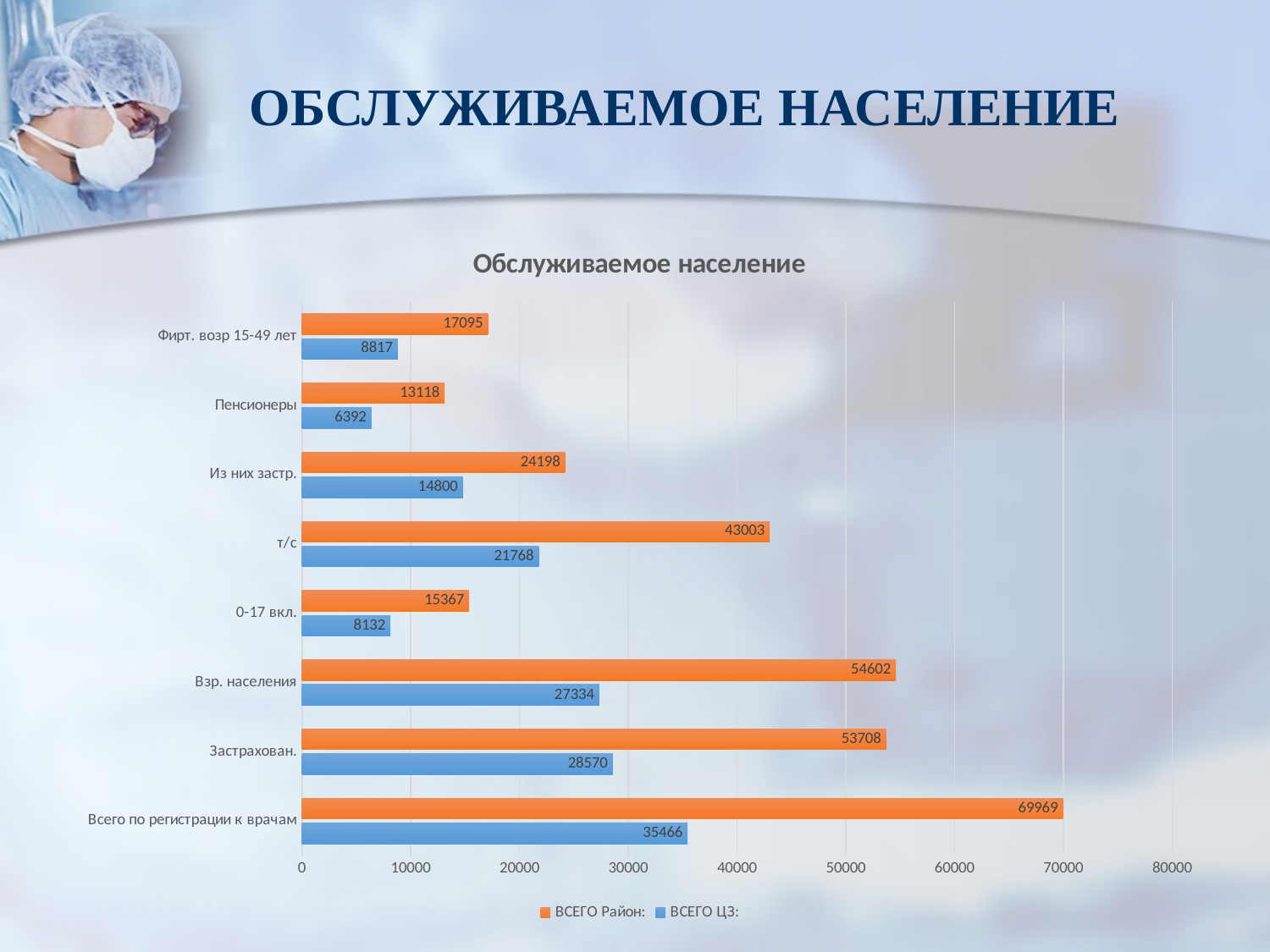
Which is larger: ВСЕГО ЦЗ: for Застрахован. or ВСЕГО ЦЗ: for Взр. населения? Застрахован. Which category has the lowest value for ВСЕГО Район:? Пенсионеры What is the value of ВСЕГО ЦЗ: for т/с? 21768 What is the value of ВСЕГО Район: for Из них застр.? 24198 Is the value of ВСЕГО Район: for т/с greater or less than 40000? greater What type of chart is shown on the slide? bar chart Which category has the highest value for ВСЕГО ЦЗ:? Всего по регистрации к врачам What is the difference between ВСЕГО Район: and ВСЕГО ЦЗ: for Взр. населения? 27268 How many series does the legend list? 2 What is the value of ВСЕГО Район: for Всего по регистрации к врачам? 69969 How many categories are shown on the chart? 8 What is the value of ВСЕГО ЦЗ: for Пенсионеры? 6392